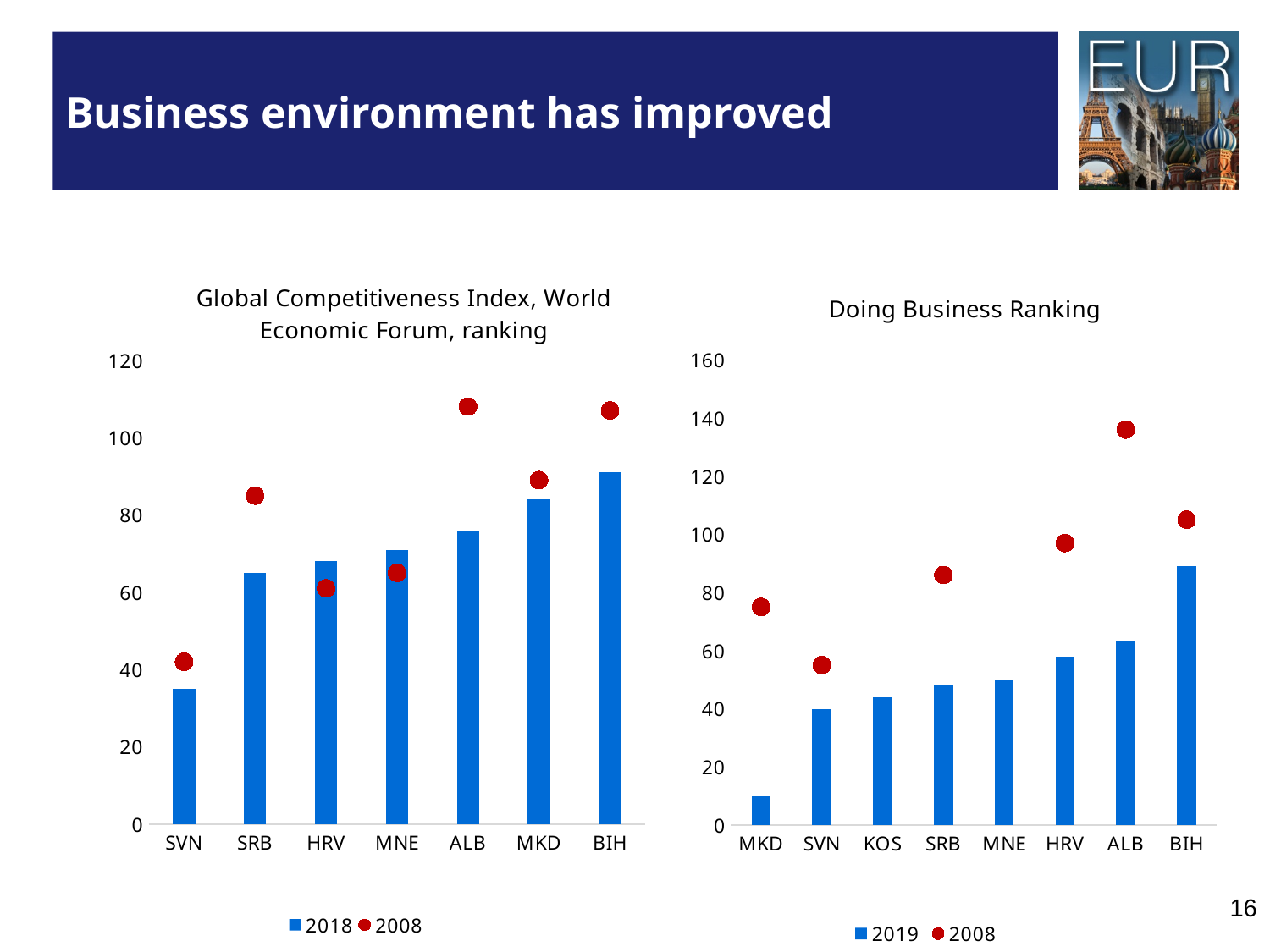
In the Global Competitiveness Index chart, what kind of chart is used to show the 2018 values? bar chart In the Doing Business Ranking chart, which country has the lowest 2019 value? MKD In the Global Competitiveness Index chart, which country has the highest 2018 value? BIH In the Doing Business Ranking chart, is the 2019 value for BIH greater or less than 80? greater In the Global Competitiveness Index chart, how many countries are shown on the x axis? 7 In the Doing Business Ranking chart, how many countries are shown on the x axis? 8 In the Global Competitiveness Index chart, is the 2018 value for SVN greater or less than 40? less In the Global Competitiveness Index chart, which country has the lowest 2018 value? SVN In the Doing Business Ranking chart, do the 2019 bars rise or fall from left to right along the x axis? rise In the Doing Business Ranking chart, which country has the highest 2008 value? ALB In the Global Competitiveness Index chart, is the 2008 value for ALB greater or less than 100? greater In the Global Competitiveness Index chart, how many series does the legend list? 2